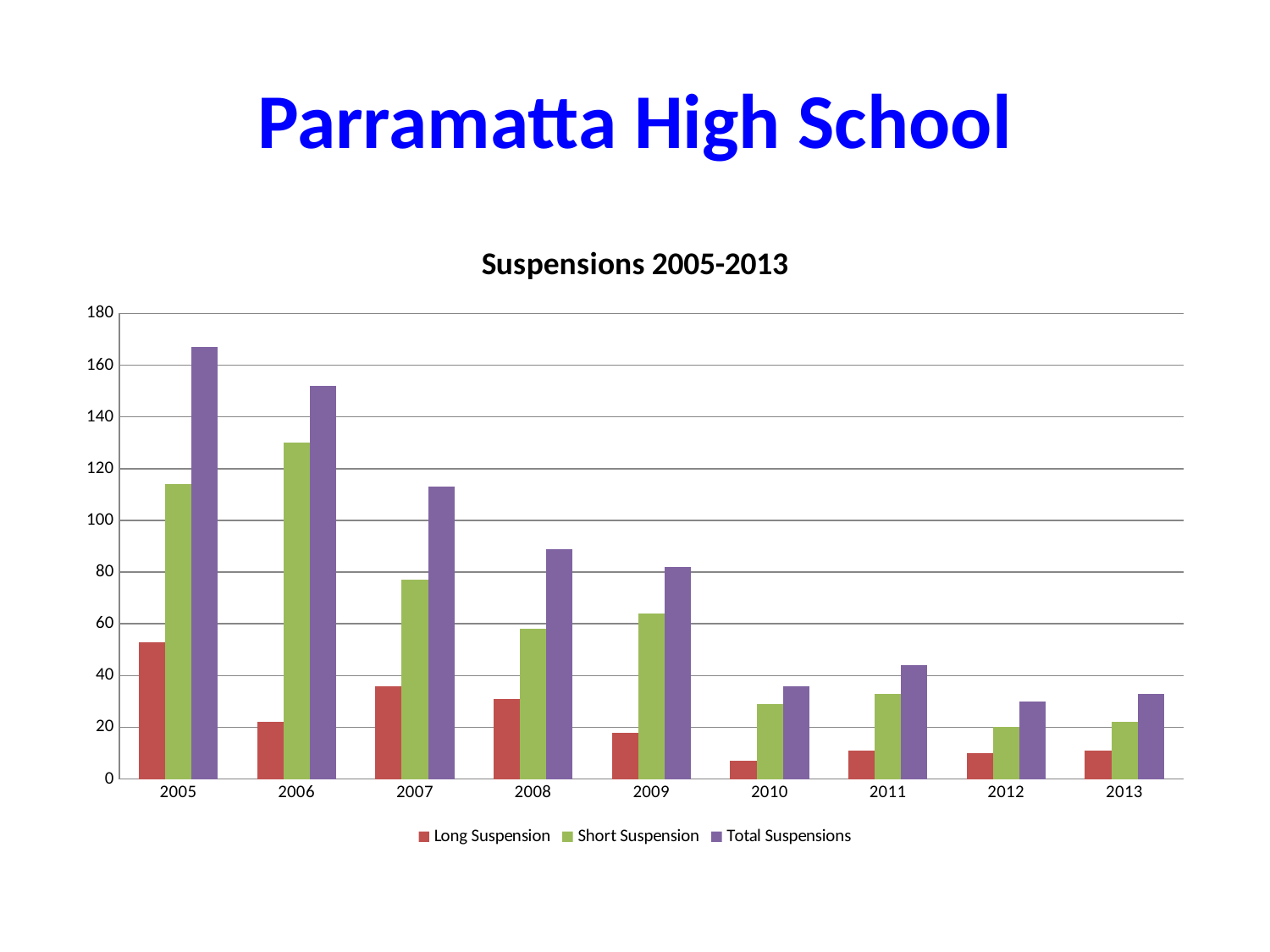
What is the title of the chart? Suspensions 2005-2013 Is the Total Suspensions value for 2005 greater or less than 160? greater Which year has the highest Short Suspension value? 2006 Do Total Suspensions rise or fall from 2005 to 2010? fall What kind of chart is shown on the slide? bar chart Which year has the highest Total Suspensions? 2005 How many years are shown on the x axis? 9 Which year has the larger Short Suspension value, 2005 or 2006? 2006 Is the Long Suspension value for 2005 greater or less than 40? greater Which year has the lowest Long Suspension value? 2010 How many series does the legend list? 3 Is the Short Suspension value for 2007 greater or less than 80? less